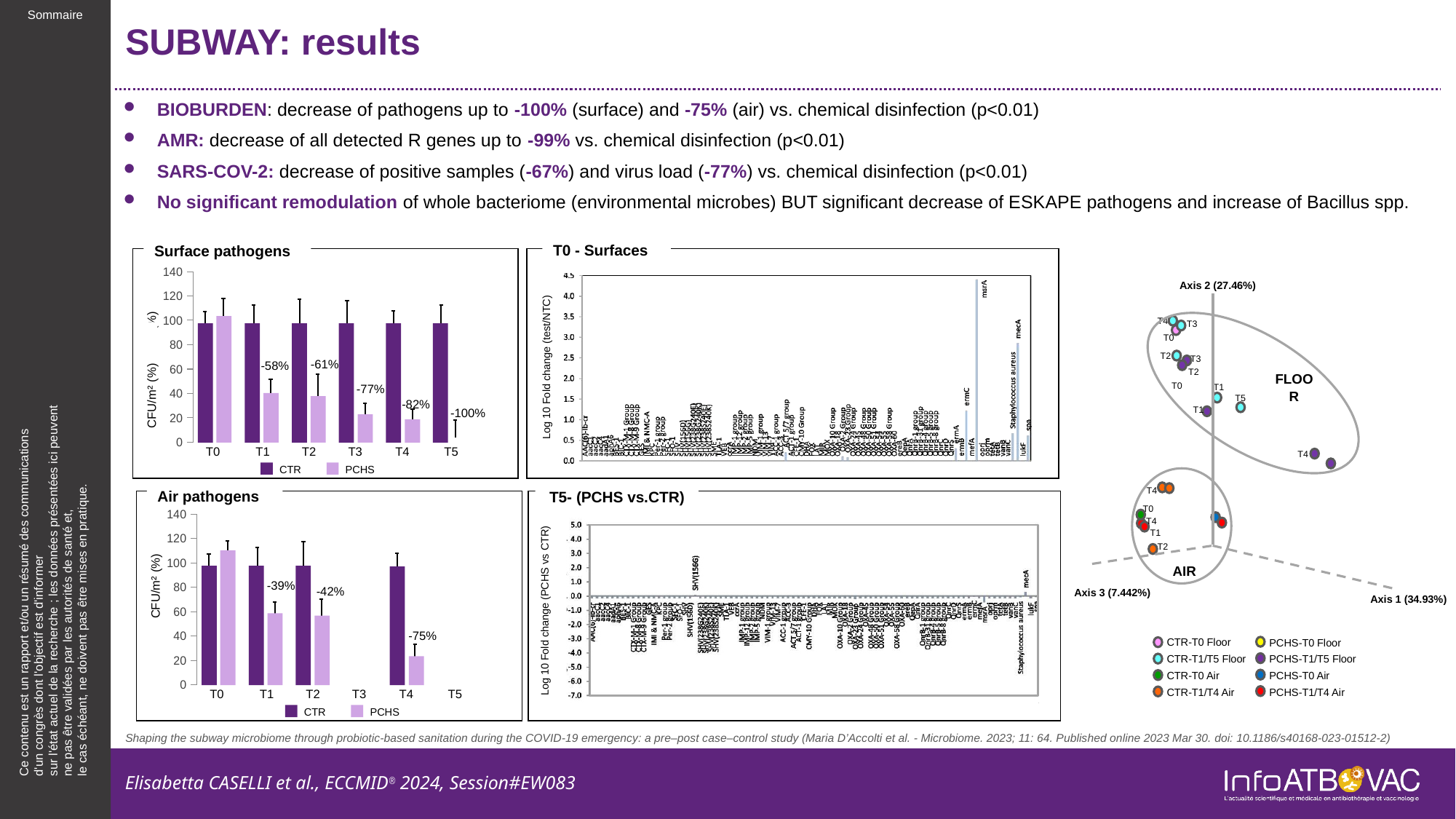
How many series does the legend of the Surface pathogens chart list? 2 In the Surface pathogens chart, which series is larger at T2, CTR or PCHS? CTR In the Surface pathogens chart, what percentage label is shown above the T3 bars? -77% How many entries does the legend of the scatter plot on the right (Axis 1 / Axis 2) list? 8 In the Surface pathogens chart, do the PCHS bars rise or fall from T0 to T5? fall In the Surface pathogens chart, is the PCHS value at T1 greater or less than 60? less In the Air pathogens chart, what percentage label is shown above the T1 bars? -39% In the Air pathogens chart, what percentage label is shown above the T4 bars? -75% What kind of chart is the Surface pathogens chart? bar chart In the Surface pathogens chart, what percentage label is shown at T5? -100% In the Air pathogens chart, is the PCHS value at T0 greater or less than 100? greater In the Air pathogens chart, which time point has the lowest PCHS bar among those plotted? T4